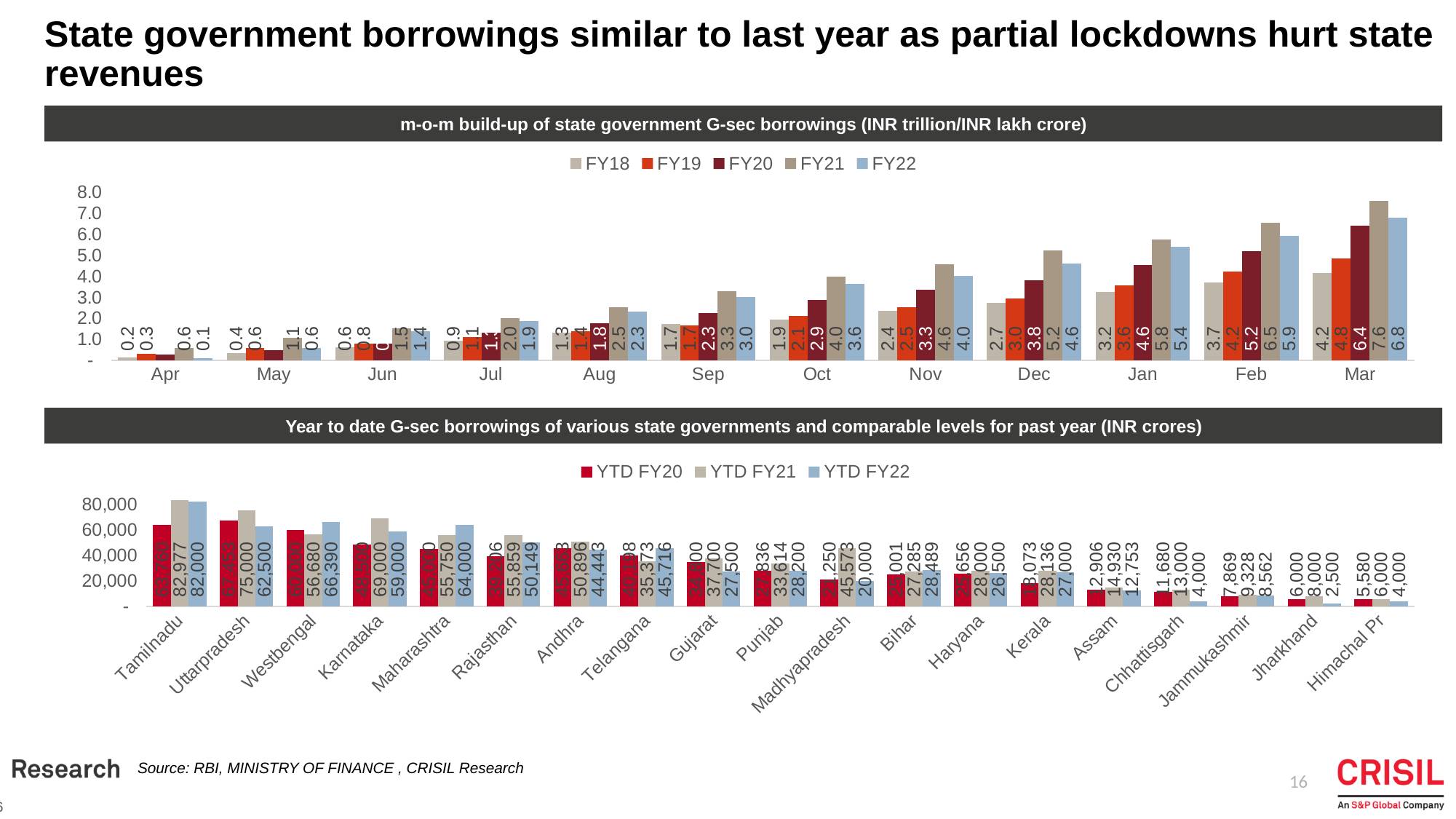
What kind of chart is the top chart (m-o-m build-up of state government G-sec borrowings)? bar chart In the bottom chart (Year to date G-sec borrowings of various state governments), is the YTD FY21 or the YTD FY22 value larger for Karnataka? YTD FY21 In the top chart (m-o-m build-up of state government G-sec borrowings), what is the difference between the FY21 and FY22 values for Mar? 0.8 In the bottom chart (Year to date G-sec borrowings of various state governments), what is the YTD FY22 value for Westbengal? 66,390 In the top chart (m-o-m build-up of state government G-sec borrowings), do the FY21 values rise or fall from Apr to Mar? rise How many series does the legend of the top chart (m-o-m build-up of state government G-sec borrowings) list? 5 In the bottom chart (Year to date G-sec borrowings of various state governments), which state has the highest YTD FY21 value? Tamilnadu In the top chart (m-o-m build-up of state government G-sec borrowings), what is the FY21 value for Dec? 5.2 In the top chart (m-o-m build-up of state government G-sec borrowings), which series has the highest value in Mar? FY21 How many states are shown on the x axis of the bottom chart (Year to date G-sec borrowings of various state governments)? 19 In the top chart (m-o-m build-up of state government G-sec borrowings), what is the FY22 value for Mar? 6.8 In the bottom chart (Year to date G-sec borrowings of various state governments), what is the YTD FY21 value for Madhyapradesh? 45,573